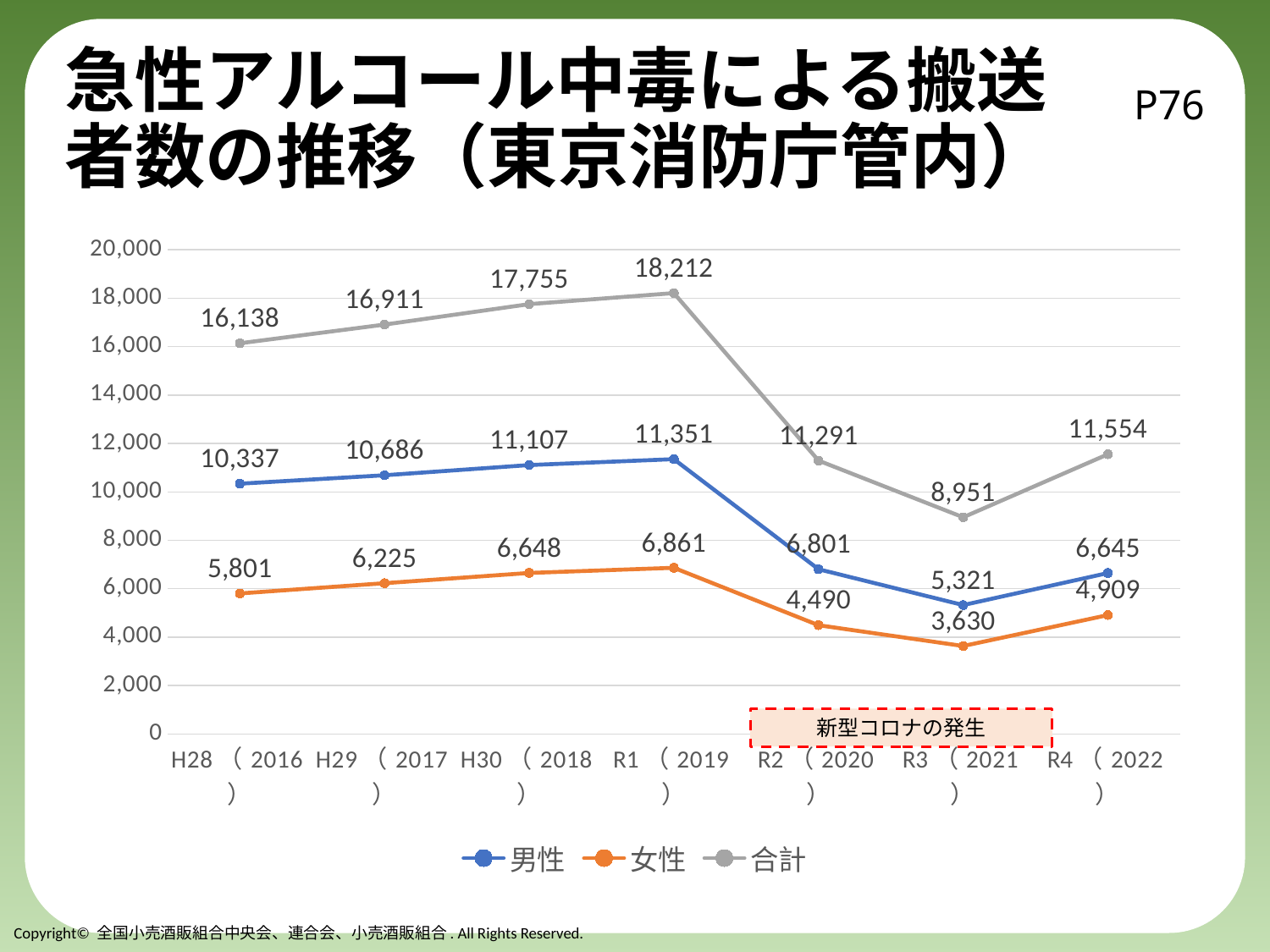
What is the value of 女性 for H28 (2016)? 5,801 In which year is the 合計 series at its highest? R1 (2019) Which is larger, the 男性 value for R4 (2022) or the 男性 value for R2 (2020)? R2 (2020) What does the dashed red box on the chart say? 新型コロナの発生 How many series does the legend list? 3 What is the value of 合計 for R1 (2019)? 18,212 What is the difference between the 合計 values for R1 (2019) and R2 (2020)? 6,921 How does the 合計 series change from H28 (2016) to R1 (2019)? It rises How many years (data points per series) are plotted on the x axis? 7 What type of chart is shown on the slide? line chart In which year is the 女性 series at its lowest? R3 (2021) What is the value of 男性 for R3 (2021)? 5,321